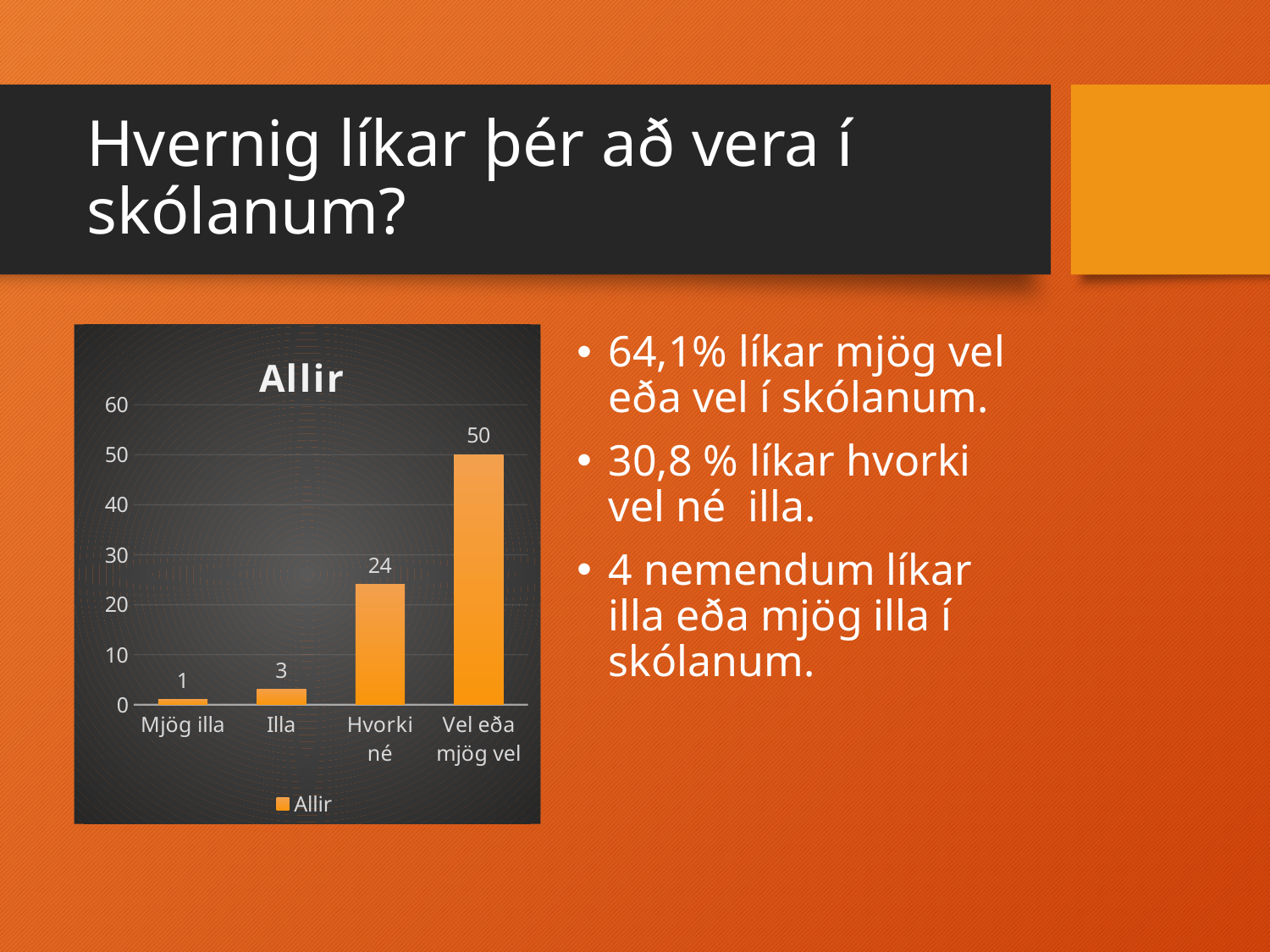
What is the value for "Hvorki né"? 24 Which is larger, the value for "Illa" or the value for "Hvorki né"? Hvorki né What is the difference between the values for "Vel eða mjög vel" and "Hvorki né"? 26 What is the title of the chart? Allir Is the value for "Hvorki né" greater or less than 30? less What is the value for "Mjög illa"? 1 Which category has the lowest value? Mjög illa What is the value for "Vel eða mjög vel"? 50 Which category has the highest value? Vel eða mjög vel How many categories are shown on the x axis? 4 What kind of chart is shown on the slide? bar chart What is the value for "Illa"? 3